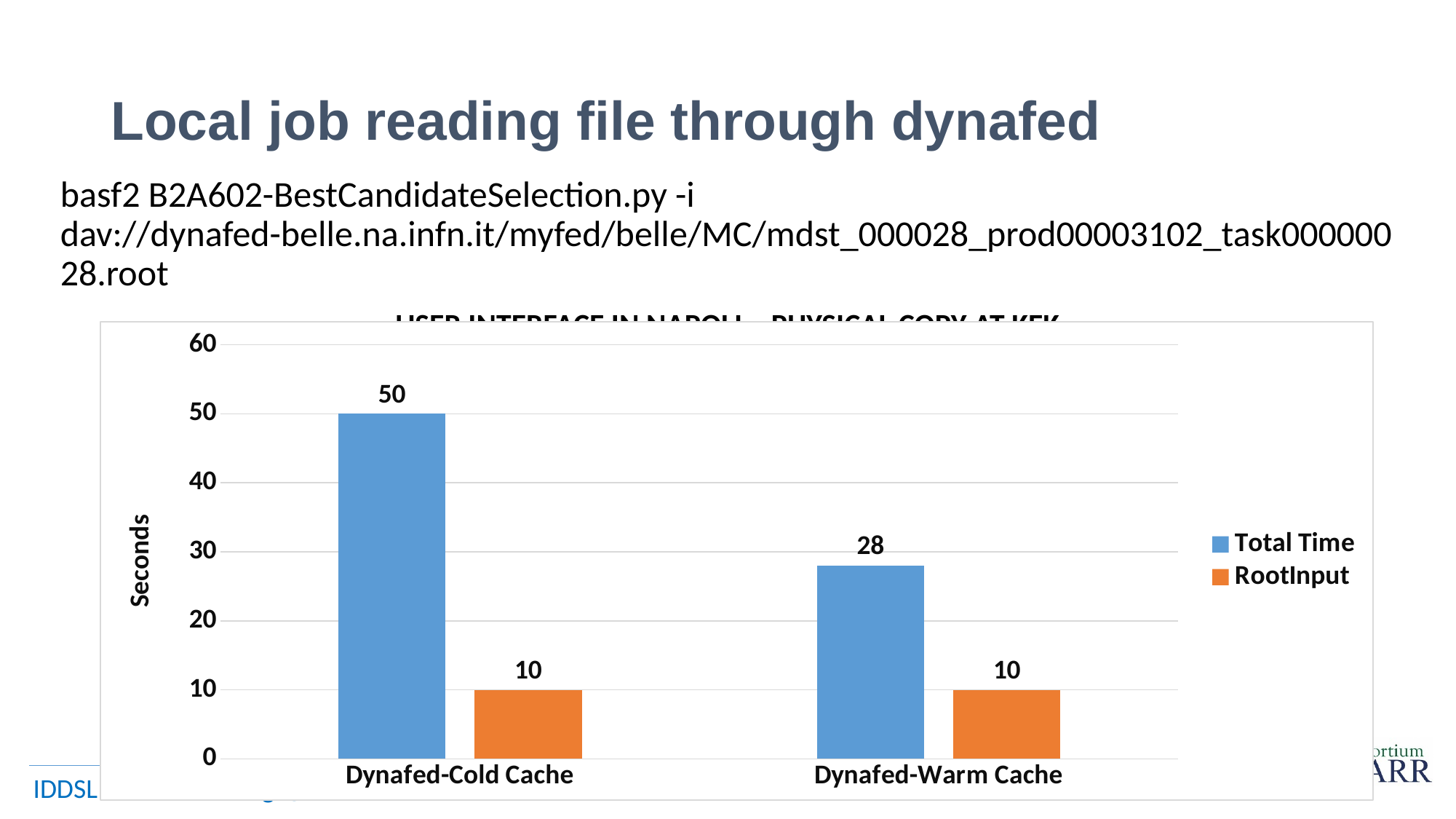
How many series does the legend list? 2 What is the label of the vertical axis? Seconds Is the Total Time for Dynafed-Cold Cache larger or smaller than the Total Time for Dynafed-Warm Cache? larger What is the difference in Total Time between Dynafed-Cold Cache and Dynafed-Warm Cache? 22 What is the Total Time value for Dynafed-Warm Cache? 28 What is the Total Time value for Dynafed-Cold Cache? 50 How many categories are shown on the x axis? 2 What kind of chart is shown on the slide? bar chart What is the RootInput value for Dynafed-Warm Cache? 10 What is the RootInput value for Dynafed-Cold Cache? 10 Which category has the higher Total Time? Dynafed-Cold Cache For Dynafed-Warm Cache, what is the difference between Total Time and RootInput? 18